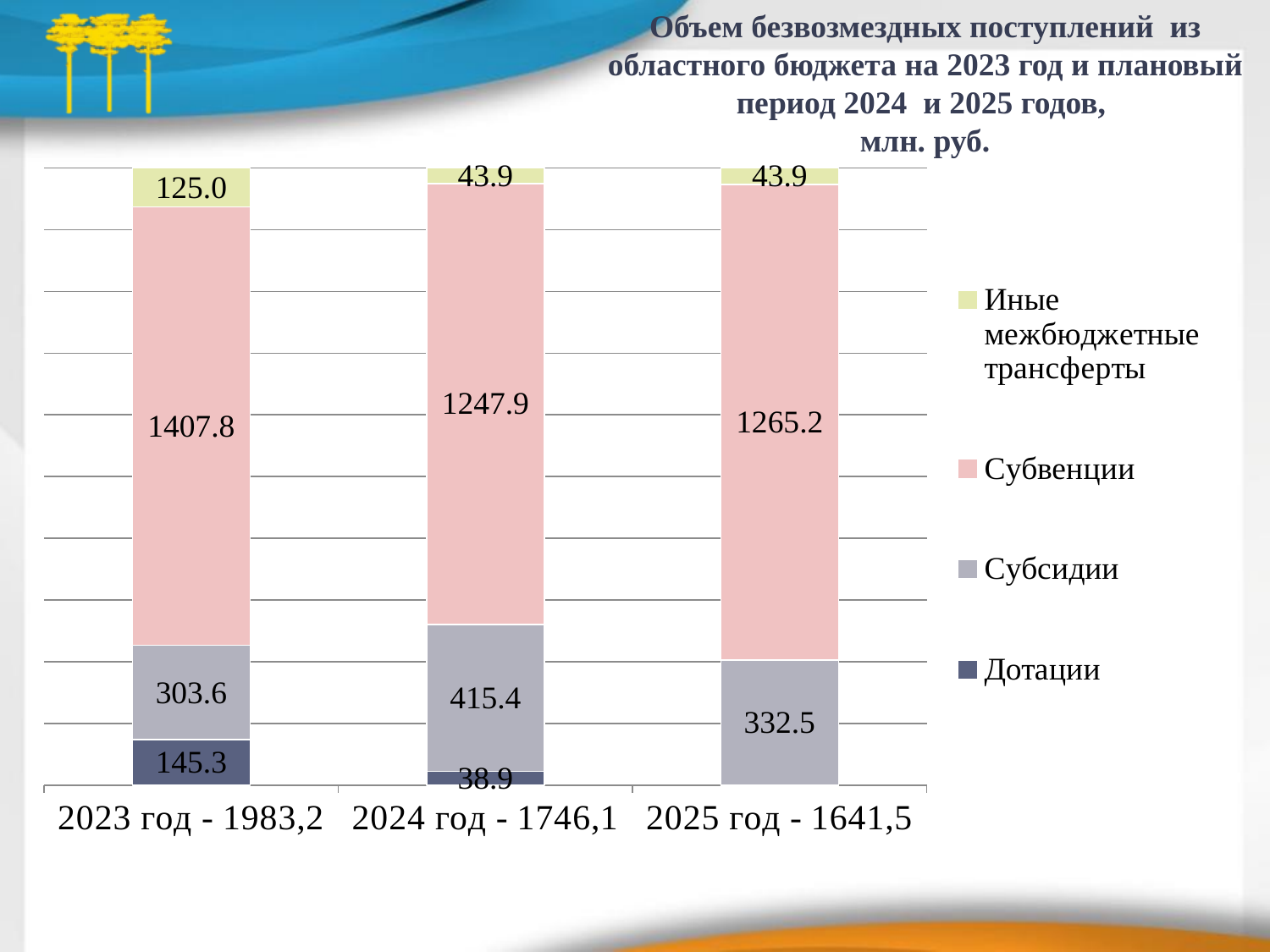
What is the value of Субвенции for 2023 год? 1407.8 What kind of chart is shown on the slide? Stacked bar chart Which is larger, the Субвенции value for 2024 год or for 2025 год? 2025 год What is the value of Субсидии for 2024 год? 415.4 How many series does the legend list? 4 How many years (categories) are shown on the x axis? 3 What is the total of the stacked bar for 2024 год? 1746,1 In which year is the Субвенции value the highest? 2023 год What is the value of Дотации for 2023 год? 145.3 Between 2023 год and 2024 год, which year has the smaller Дотации value? 2024 год What is the value of Иные межбюджетные трансферты for 2025 год? 43.9 What is the difference between the Субсидии values for 2024 год and 2023 год? 111.8